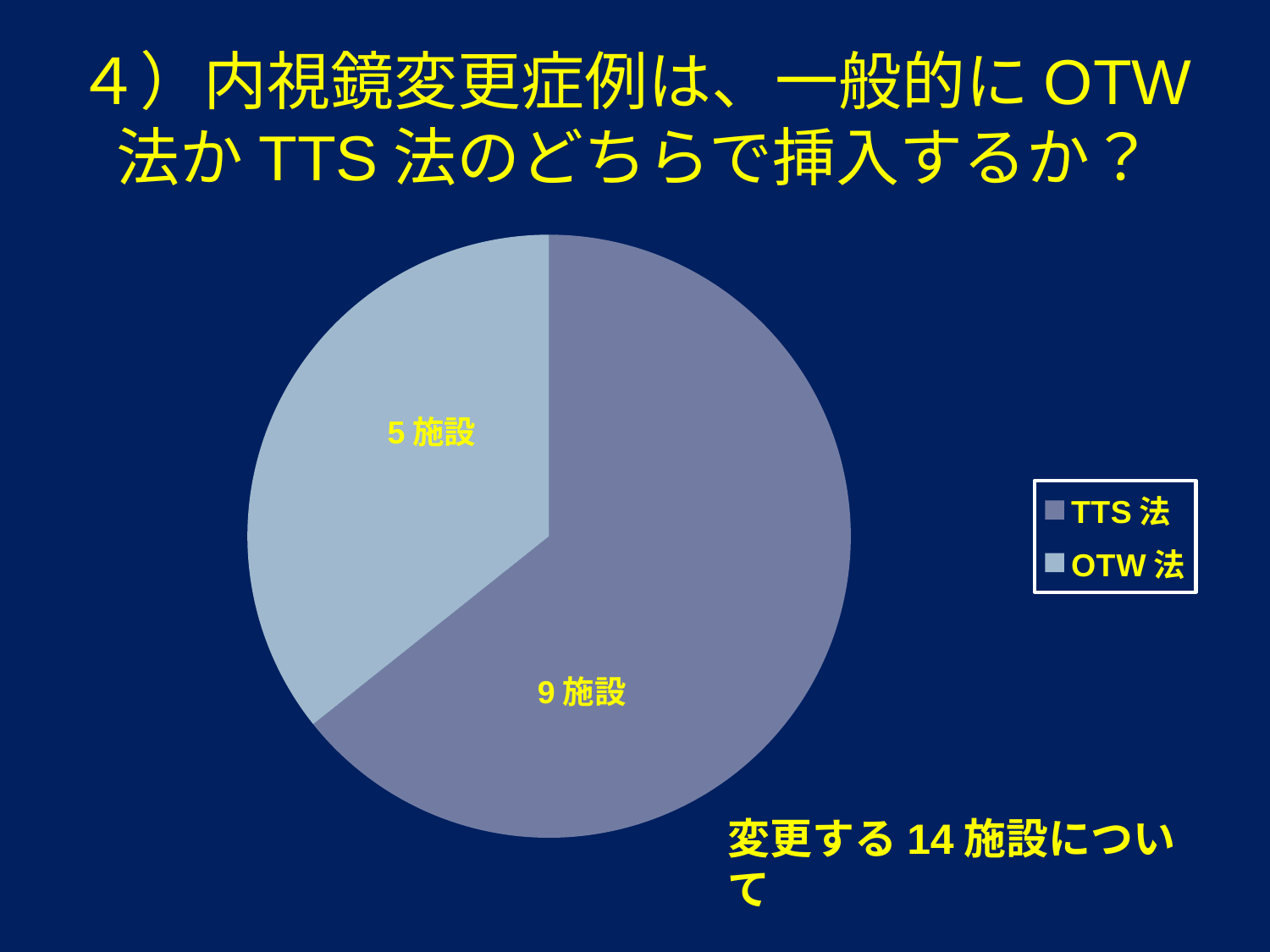
Which method has the larger slice of the pie, TTS法 or OTW法? TTS法 What is the difference in the number of facilities between TTS法 and OTW法? 4 How many facilities (施設) are shown for TTS法? 9 施設 How many entries does the legend list? 2 Which legend entry is shown with the lighter blue colour? OTW法 What share of the 14 facilities does the TTS法 slice represent? 9/14 How many facilities (施設) are shown for OTW法? 5 施設 Which category has the largest slice in the pie chart? TTS法 What kind of chart is shown on the slide? pie chart What is the total number of facilities represented in the pie chart? 14 How many slices does the pie chart have? 2 Which category has the smallest slice in the pie chart? OTW法